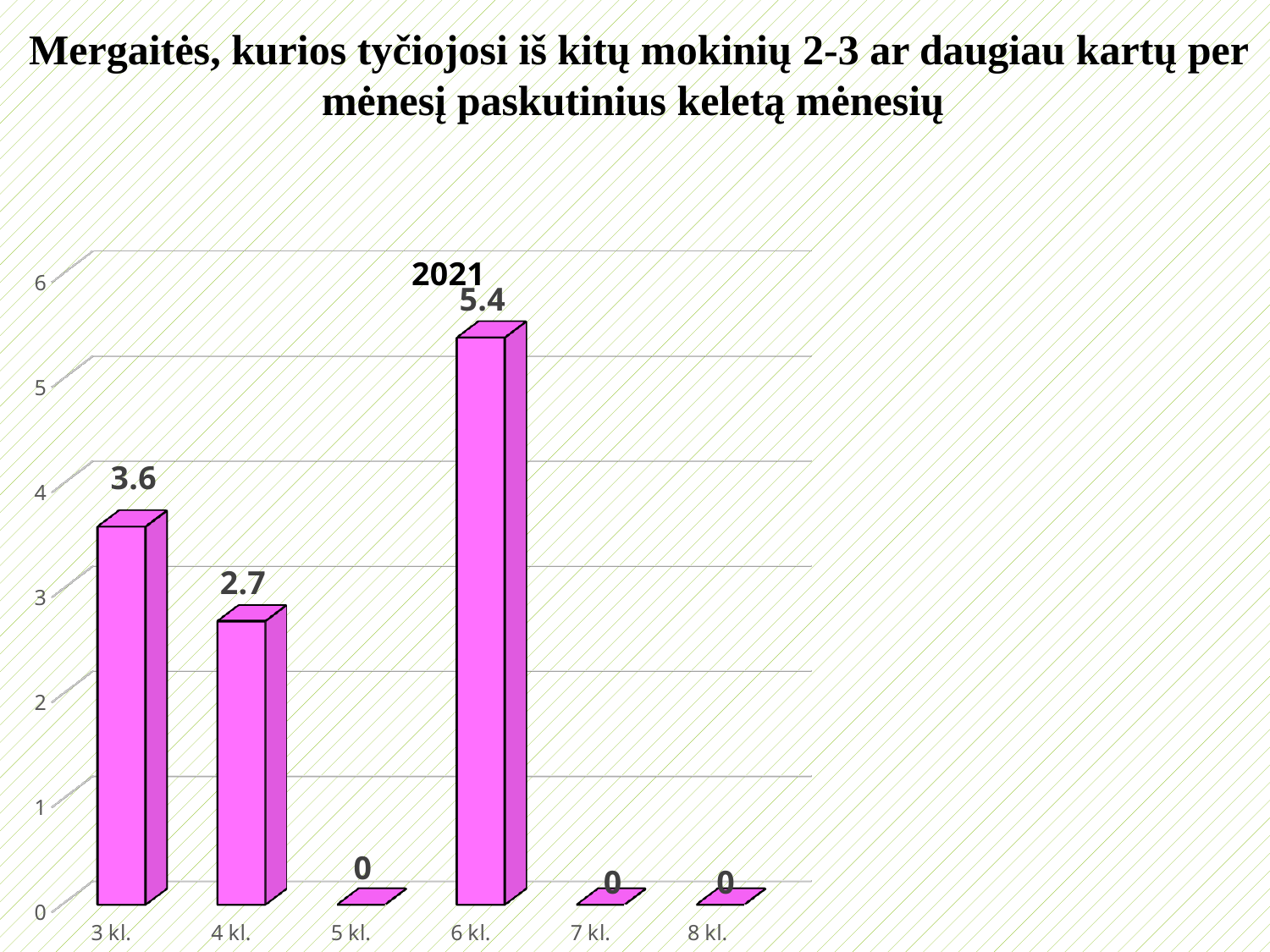
What is the difference between the values for 6 kl. and 3 kl.? 1.8 Which is larger, the value for 3 kl. or the value for 4 kl.? 3 kl. What is the value for 3 kl.? 3.6 Which category has the highest value? 6 kl. What is the value for 4 kl.? 2.7 What kind of chart is this? bar chart How many categories are shown on the x axis? 6 What is the value for 6 kl.? 5.4 Is the value for 6 kl. greater or less than 5? greater What is the difference between the values for 3 kl. and 4 kl.? 0.9 What is the value for 5 kl.? 0 What series label is shown above the 6 kl. bar? 2021